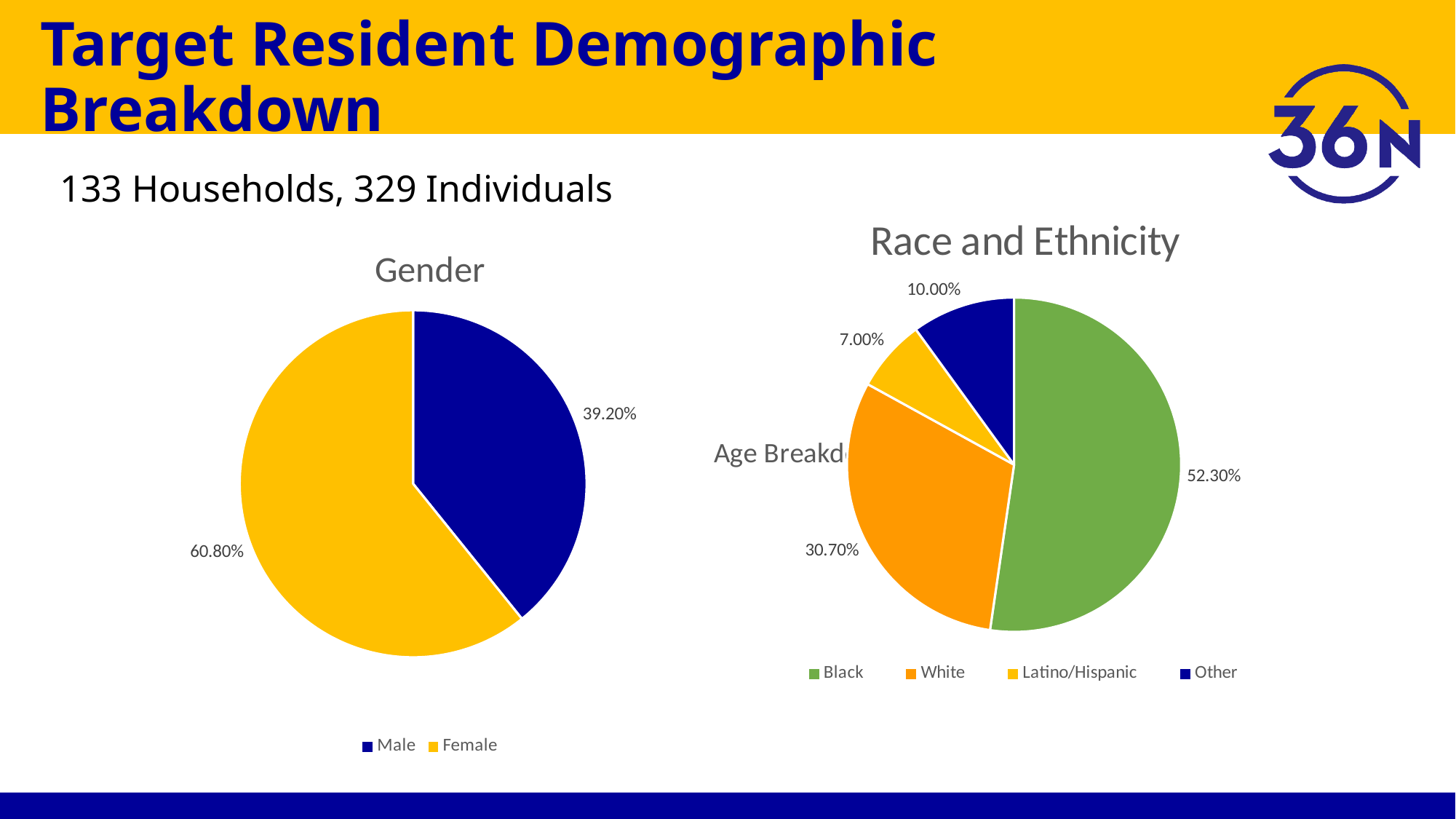
In the Gender chart, which category has the larger share? Female In the Race and Ethnicity chart, which is larger, the share for Other or the share for Latino/Hispanic? Other In the Race and Ethnicity chart, what percentage is shown for White? 30.70% In the Race and Ethnicity chart, what percentage is shown for Latino/Hispanic? 7.00% What type of chart is the Gender chart? Pie chart In the Gender chart, what is the difference between the Female and Male percentages? 21.60% In the Race and Ethnicity chart, what is the difference between the Black and White percentages? 21.60% In the Gender chart, what percentage is shown for Female? 60.80% In the Gender chart, what percentage is shown for Male? 39.20% In the Race and Ethnicity chart, what percentage is shown for Black? 52.30% In the Race and Ethnicity chart, which category has the smallest share? Latino/Hispanic How many categories does the legend of the Race and Ethnicity chart list? 4